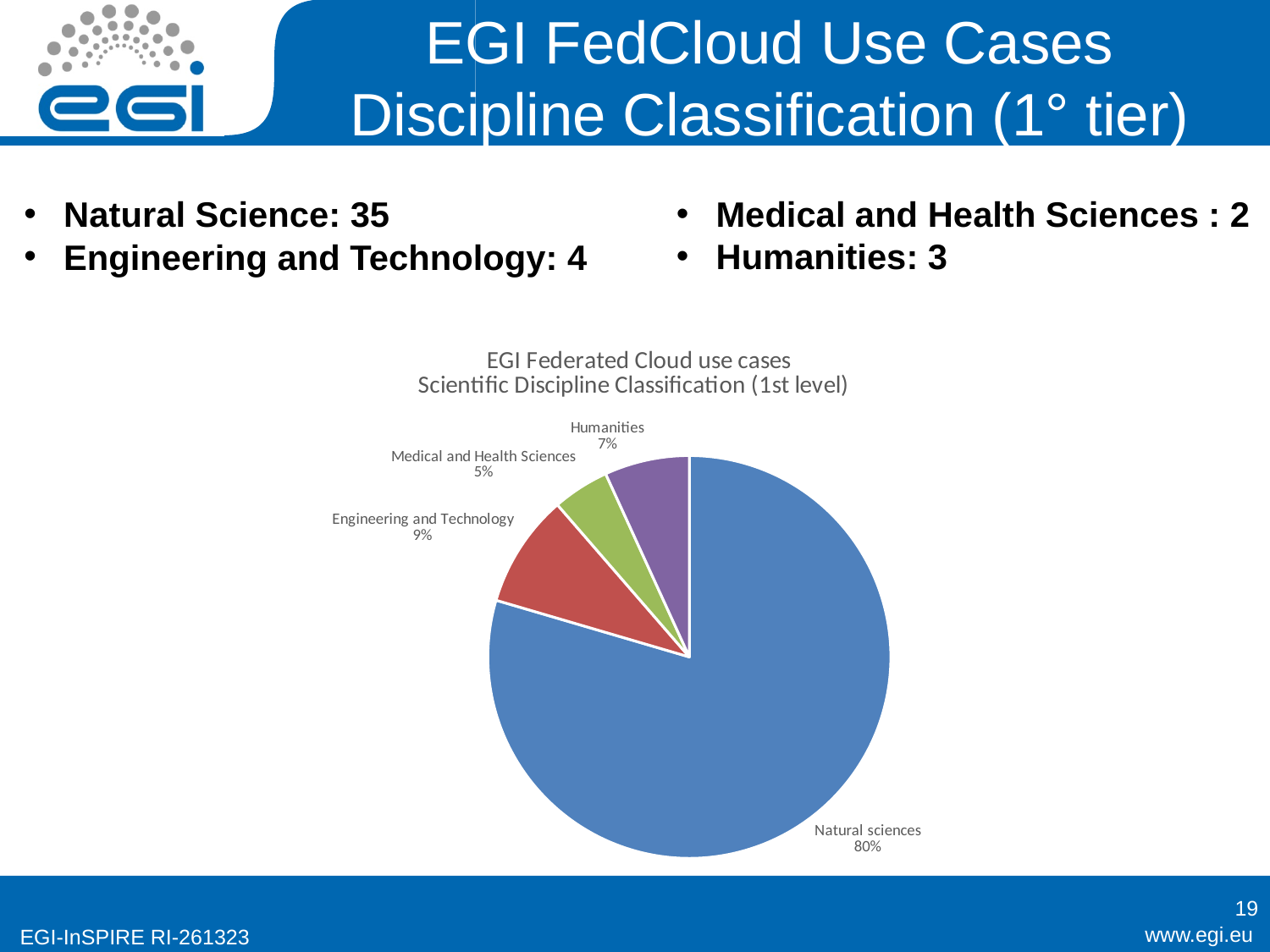
What kind of chart is shown on the slide? pie chart What share of the pie does Natural sciences represent? 80% Which discipline has the largest slice of the pie? Natural sciences Which discipline has the smallest slice of the pie? Medical and Health Sciences What share of the pie does Engineering and Technology represent? 9% What share of the pie does Humanities represent? 7% What is the title of the pie chart? EGI Federated Cloud use cases Scientific Discipline Classification (1st level) What colour is the Natural sciences slice? blue How many slices does the pie chart have? 4 Which slice is larger, Engineering and Technology or Humanities? Engineering and Technology What is the difference in percentage points between the Natural sciences slice and the Engineering and Technology slice? 71